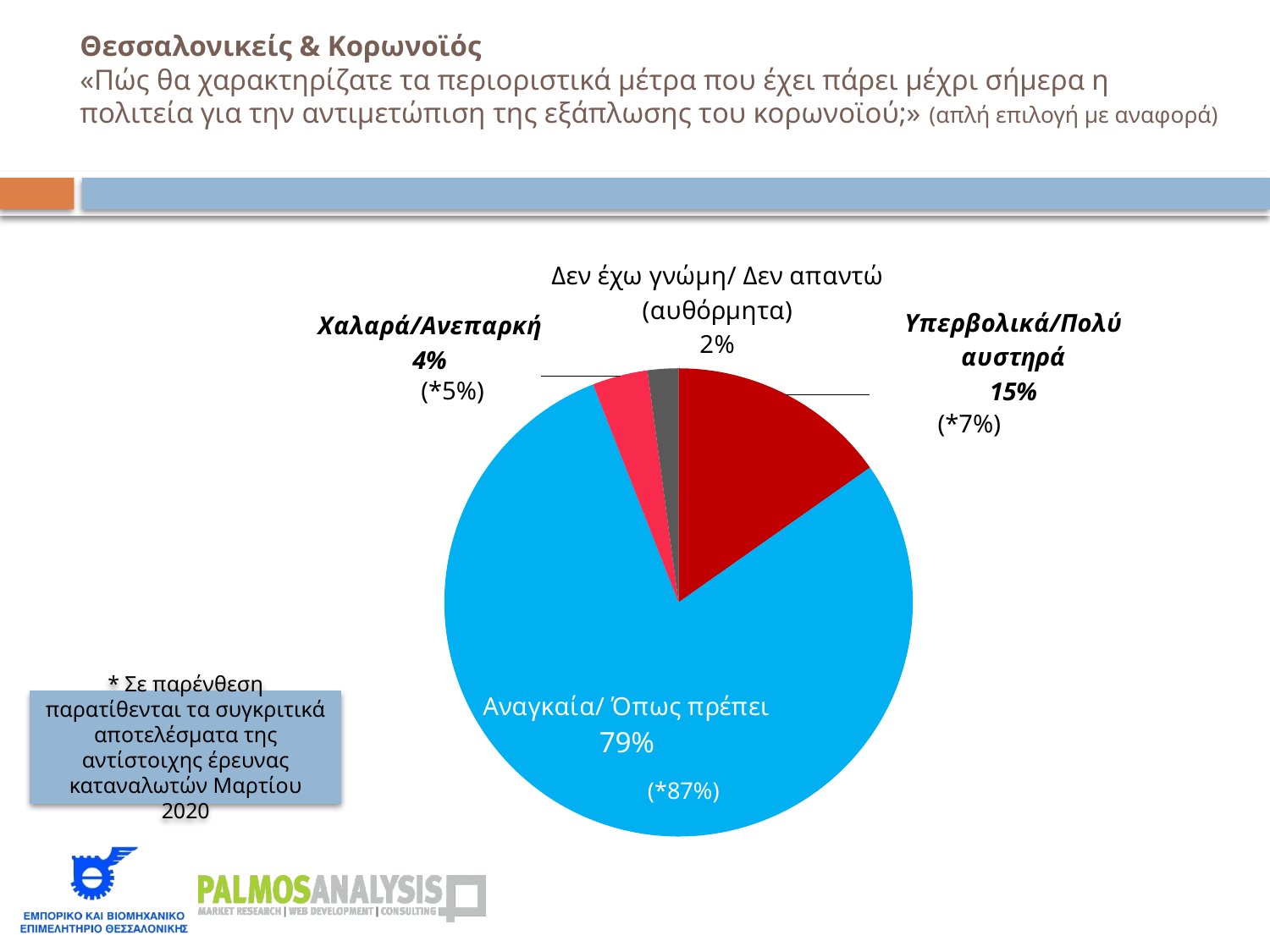
What share of respondents answered «Υπερβολικά/Πολύ αυστηρά»? 15% What kind of chart is shown on the slide? Pie chart What share of respondents answered «Αναγκαία/ Όπως πρέπει»? 79% Which answer category has the smallest slice of the pie? Δεν έχω γνώμη/ Δεν απαντώ (αυθόρμητα) What is the difference in percentage points between «Αναγκαία/ Όπως πρέπει» and «Υπερβολικά/Πολύ αυστηρά»? 64 percentage points What was the comparative March 2020 result shown in parentheses for «Αναγκαία/ Όπως πρέπει»? 87% How many categories does the pie chart show? 4 What colour is the slice for «Αναγκαία/ Όπως πρέπει»? Light blue What share of respondents answered «Χαλαρά/Ανεπαρκή»? 4% Which answer category has the largest slice of the pie? Αναγκαία/ Όπως πρέπει What share of respondents answered «Δεν έχω γνώμη/ Δεν απαντώ (αυθόρμητα)»? 2% Which is larger, the share for «Υπερβολικά/Πολύ αυστηρά» or the share for «Χαλαρά/Ανεπαρκή»? Υπερβολικά/Πολύ αυστηρά